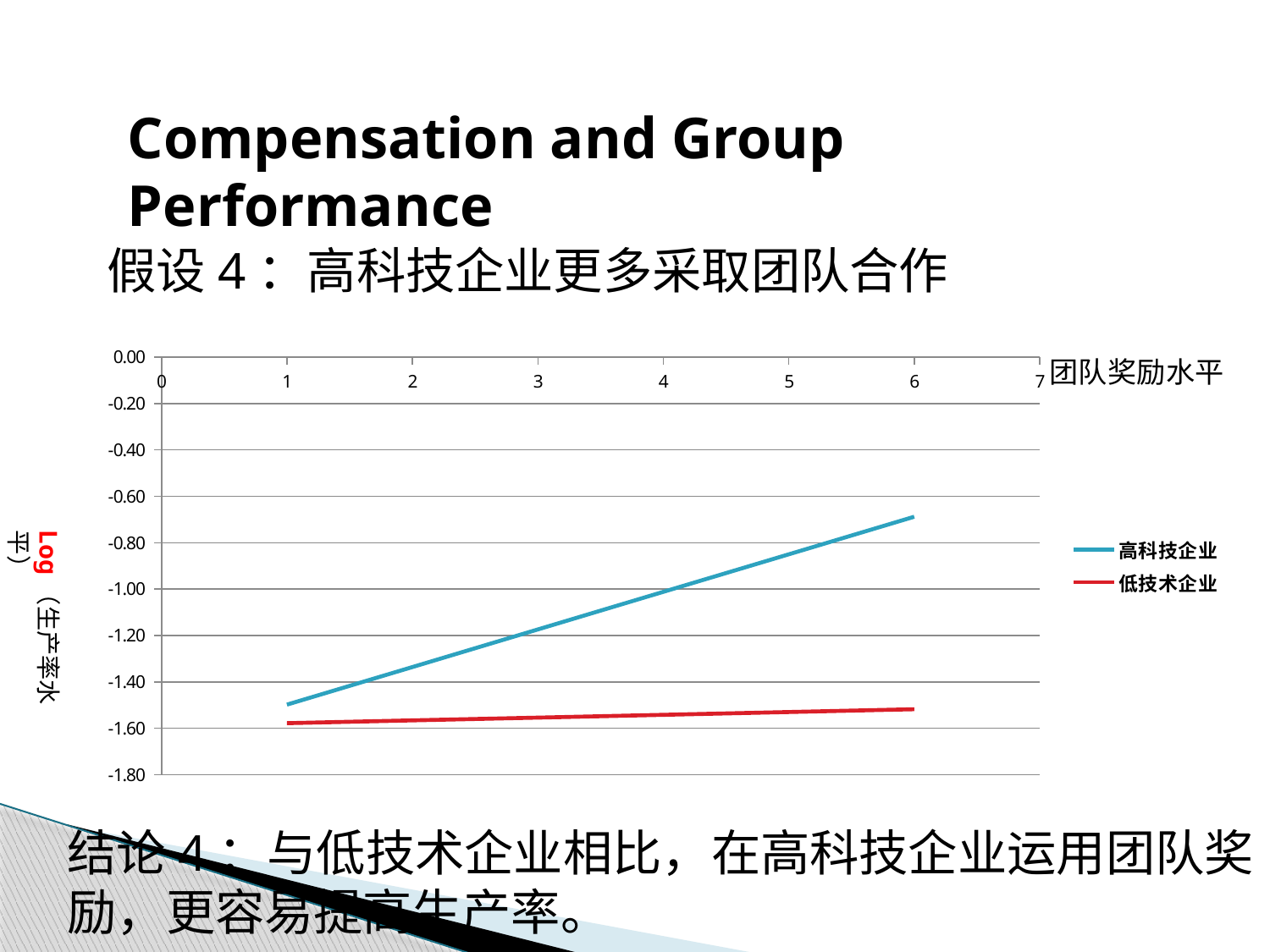
Is the value for 高科技企业 at 团队奖励水平 6 greater or less than -0.60? less Does the 低技术企业 line rise or fall as 团队奖励水平 increases? rise Is the value for 高科技企业 at 团队奖励水平 6 greater or less than -0.80? greater Which series shows the steeper increase across the x axis, 高科技企业 or 低技术企业? 高科技企业 What is the label of the x axis of the chart? 团队奖励水平 Is the value for 高科技企业 at 团队奖励水平 1 greater or less than -1.40? less How many series does the chart's legend list? 2 What kind of chart is shown on the slide? line chart Does the 高科技企业 line rise or fall as 团队奖励水平 increases? rise At 团队奖励水平 6, which series has the higher value, 高科技企业 or 低技术企业? 高科技企业 Which two series are listed in the chart's legend? 高科技企业 and 低技术企业